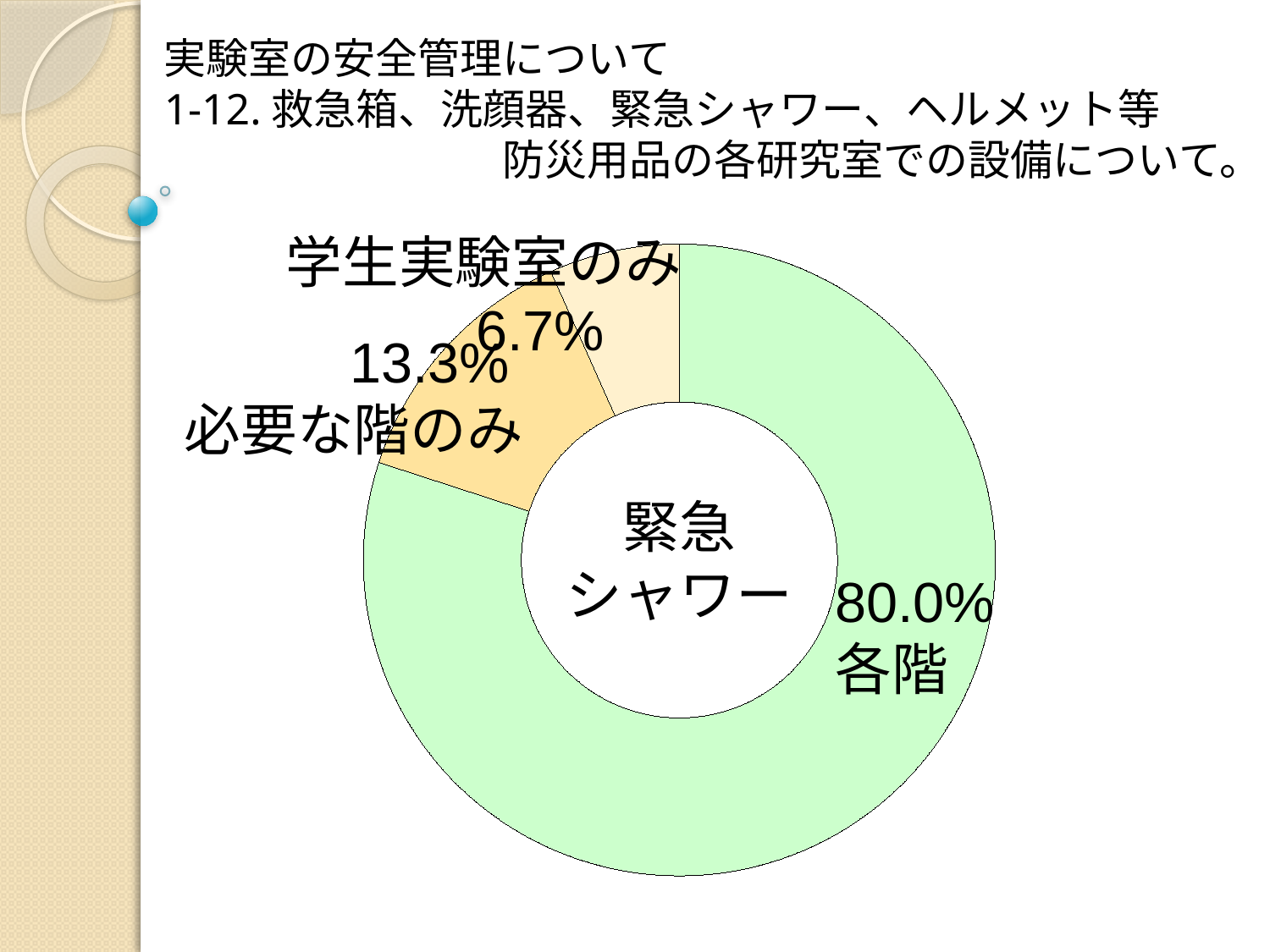
What is the difference between the values for 必要な階のみ and 学生実験室のみ? 6.6% What colour is the slice for 各階? Light green Which category has the largest share? 各階 What is the value for 学生実験室のみ? 6.7% What text is shown in the centre of the doughnut chart? 緊急シャワー What is the value for 各階? 80.0% Which category has the smallest share? 学生実験室のみ What is the difference between the values for 各階 and 必要な階のみ? 66.7% Which is larger, the value for 必要な階のみ or the value for 学生実験室のみ? 必要な階のみ How many categories does the chart show? 3 What is the value for 必要な階のみ? 13.3% What kind of chart is shown on the slide? Doughnut chart